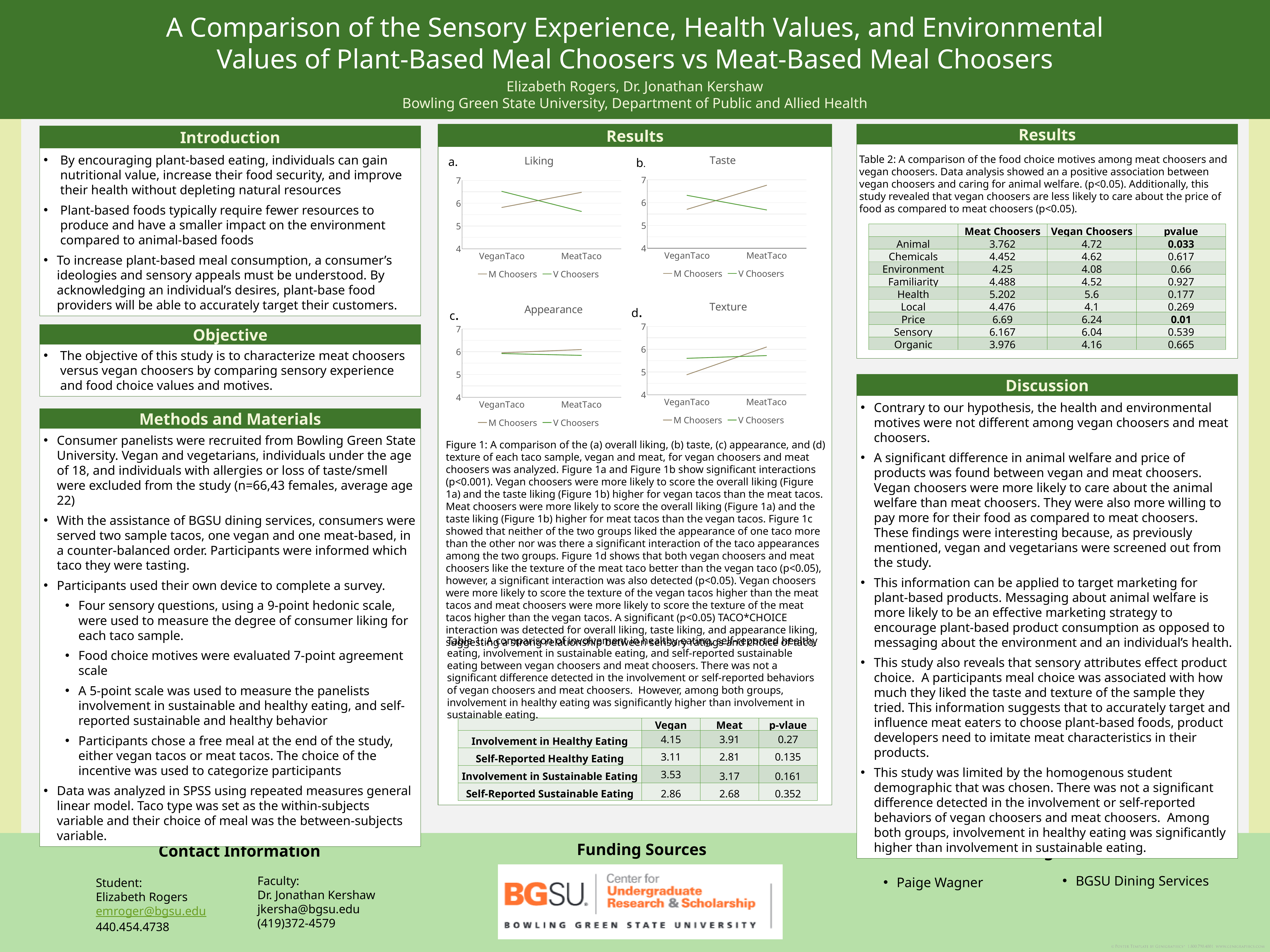
How many series does the legend of the Taste chart (panel b) list? 2 In the Taste chart (panel b), is the M Choosers value for MeatTaco greater or less than 6? greater What kind of chart is the Liking chart (panel a)? line chart In the Liking chart (panel a), does the V Choosers line rise or fall from VeganTaco to MeatTaco? fall In the Taste chart (panel b), which series has the higher value for MeatTaco, M Choosers or V Choosers? M Choosers In the Liking chart (panel a), does the M Choosers line rise or fall from VeganTaco to MeatTaco? rise In the Texture chart (panel d), does the M Choosers line rise or fall from VeganTaco to MeatTaco? rise What is the title of the chart labelled c.? Appearance In the Texture chart (panel d), which series has the higher value for VeganTaco, M Choosers or V Choosers? V Choosers How many categories are shown on the x axis of the Texture chart (panel d)? 2 In the Liking chart (panel a), is the V Choosers value for MeatTaco greater or less than 6? less